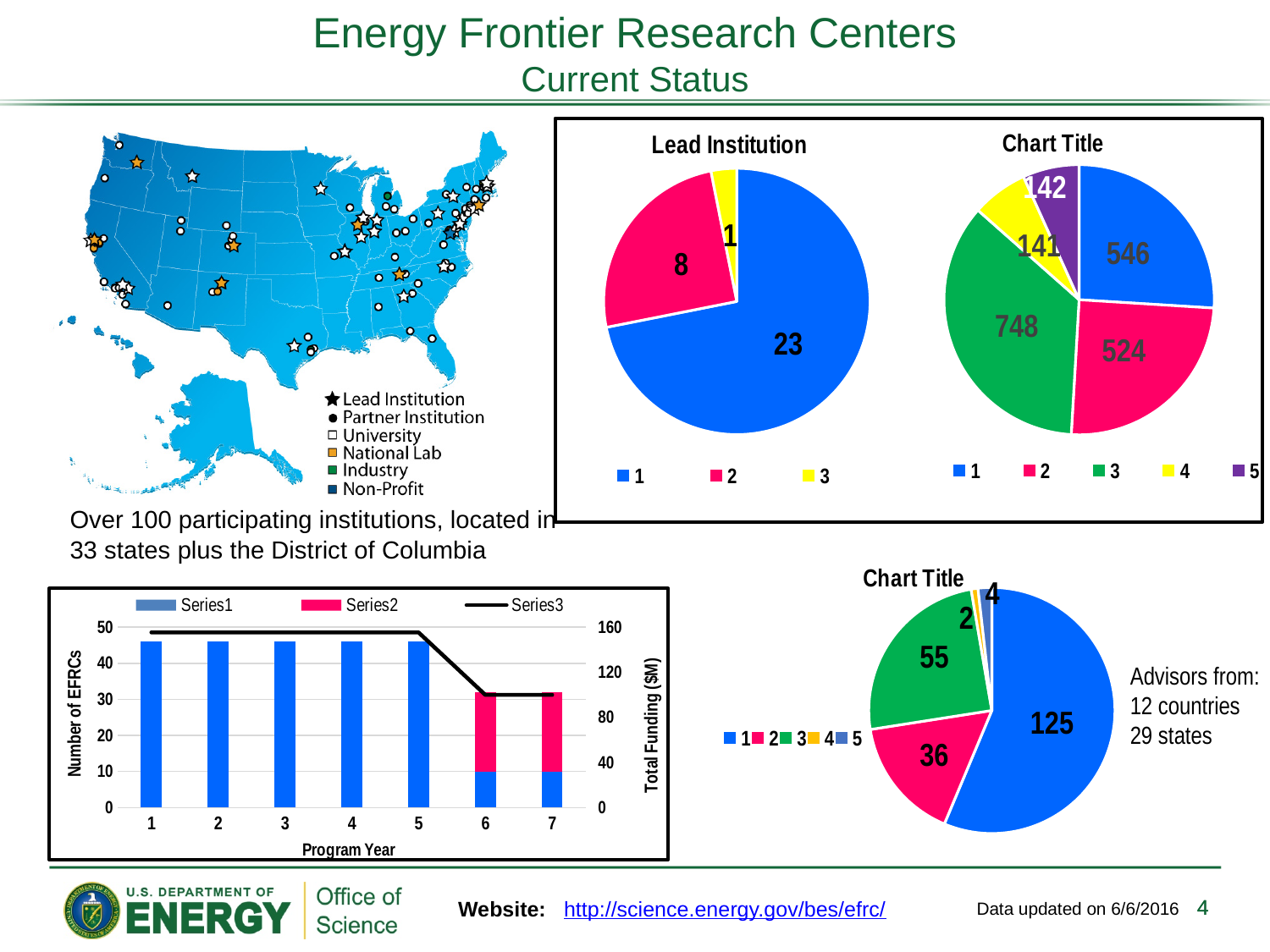
In the top-right pie chart titled Chart Title, what is the value for category 2? 524 In the bottom-right pie chart titled Chart Title, which is larger, the value for category 2 or category 3? category 3 In the Lead Institution pie chart, which category has the smallest value? 3 In the top-right pie chart titled Chart Title, which category has the largest value? 3 In the bottom-left chart, how many series does the legend list? 3 In the bottom-left chart, how many program years are shown on the x axis? 7 In the top-right pie chart titled Chart Title, how many categories does the legend list? 5 In the Lead Institution pie chart, what is the value for category 1? 23 In the bottom-left chart, is the Number of EFRCs bar for program year 1 greater or less than 40? greater In the Lead Institution pie chart, what is the difference between the values for category 1 and category 2? 15 In the bottom-right pie chart titled Chart Title, what is the value for category 3? 55 In the bottom-left chart, does the Series3 line rise or fall from program year 5 to program year 7? fall